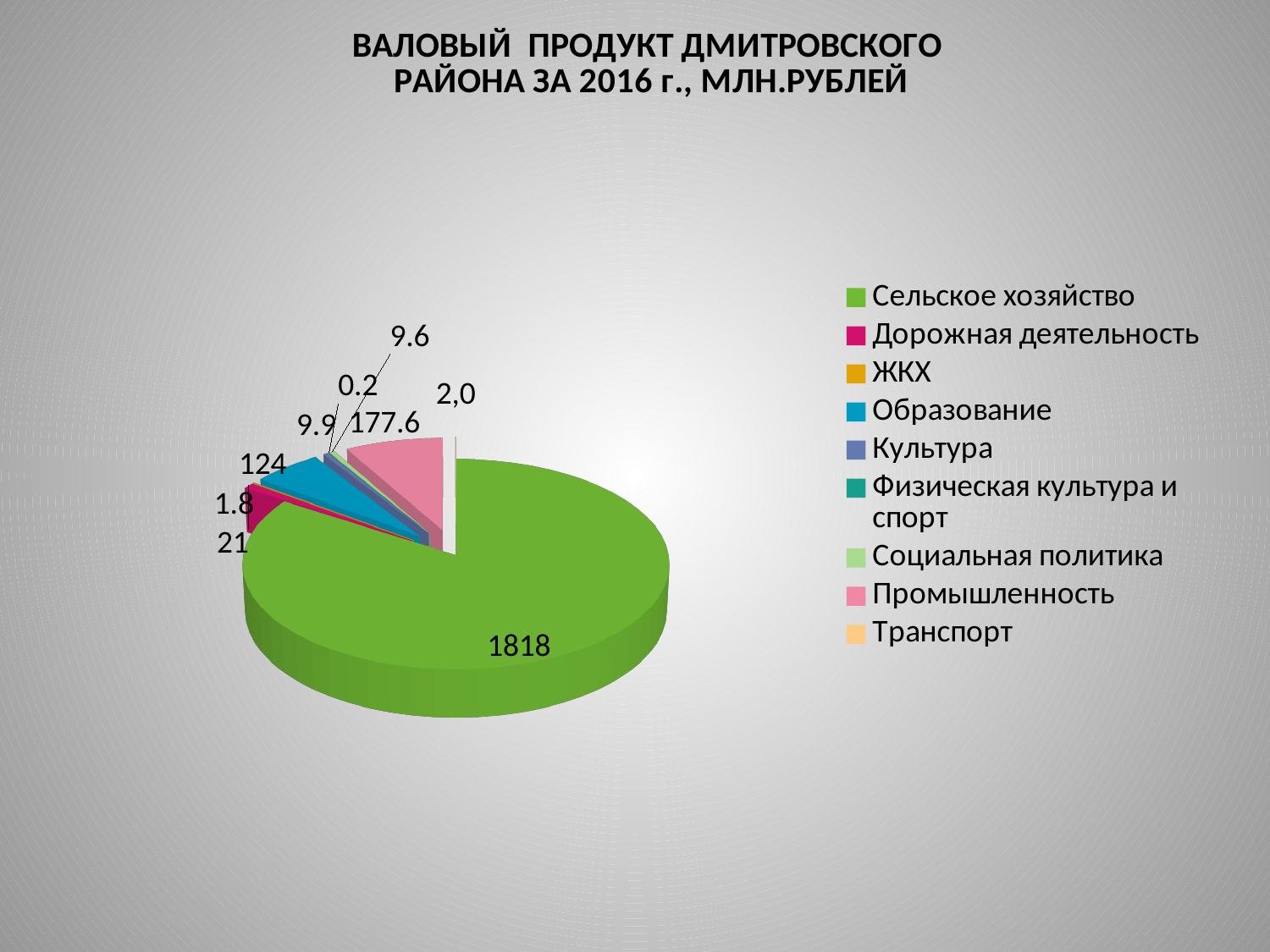
What is the value for Промышленность? 177.6 What colour is the slice for Сельское хозяйство? Green How many categories does the legend list? 9 What is the value for Дорожная деятельность? 21 What is the value for Сельское хозяйство? 1818 Which is larger, the value for Промышленность or the value for Образование? Промышленность What is the difference between the values for Промышленность and Образование? 53.6 What is the title of the chart? ВАЛОВЫЙ ПРОДУКТ ДМИТРОВСКОГО РАЙОНА ЗА 2016 г., МЛН.РУБЛЕЙ Which category has the smallest value? Физическая культура и спорт Which category has the largest slice of the pie? Сельское хозяйство What is the value for Образование? 124 What kind of chart is shown on the slide? Pie chart